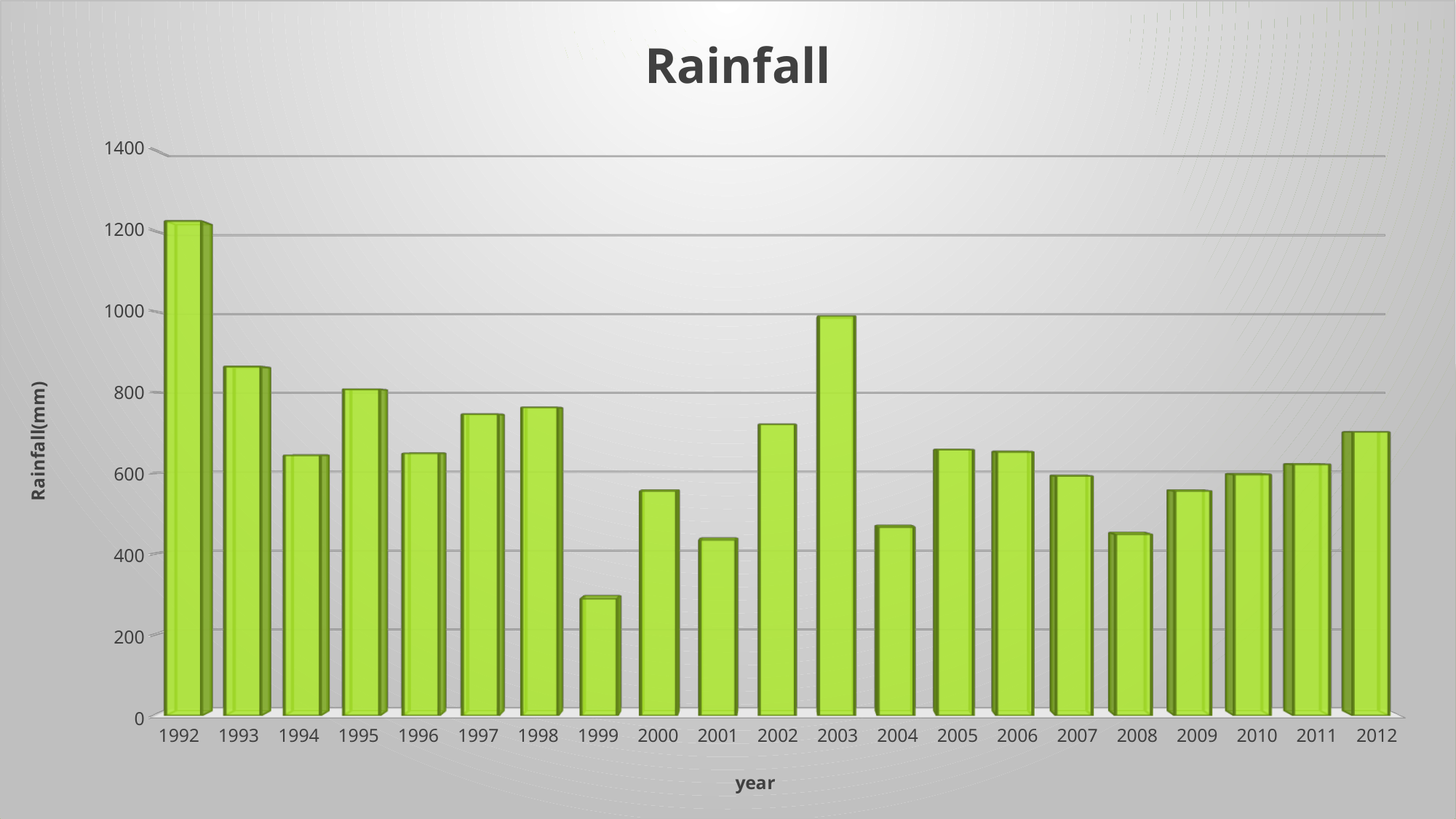
Is the rainfall for 1992 greater or less than 1000? greater Which year has the lowest rainfall? 1999 Is the rainfall for 2012 greater or less than 600? greater Which year has lower rainfall, 1999 or 2001? 1999 Which year has the highest rainfall? 1992 Is the rainfall for 2003 greater or less than 800? greater Which year has higher rainfall, 2003 or 1993? 2003 How many years are plotted on the x axis? 21 What is the label on the vertical axis? Rainfall(mm) What kind of chart is shown on the slide? bar chart